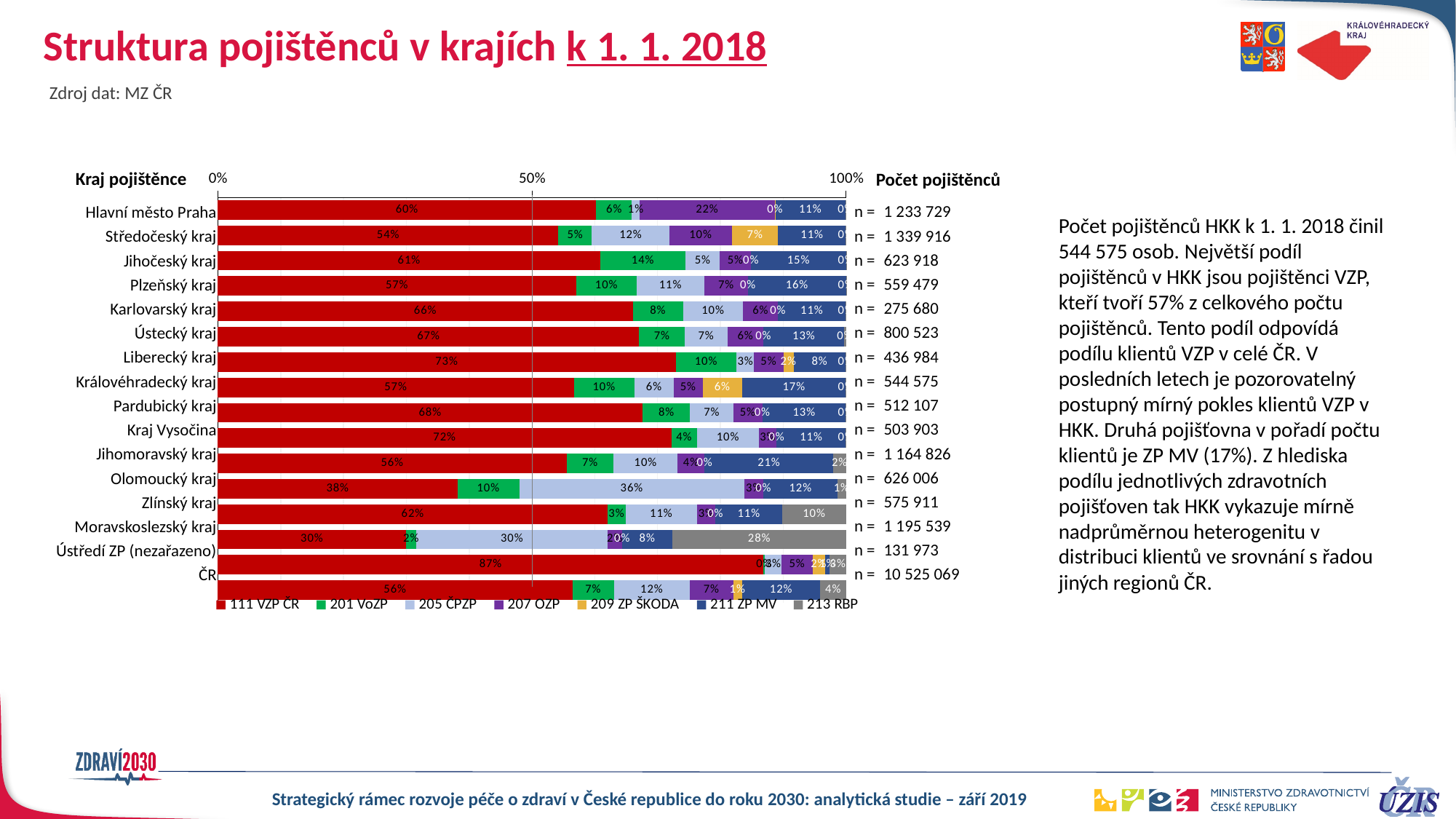
How many series does the chart legend list? 7 What is the share of 111 VZP ČR for Královéhradecký kraj? 57% What is the share of 211 ZP MV for Královéhradecký kraj? 17% How many rows (regions including ČR and Ústředí ZP) are plotted in the chart? 16 What is the difference between the 111 VZP ČR share of Liberecký kraj and that of Olomoucký kraj? 35 percentage points What is the share of 205 ČPZP for Olomoucký kraj? 36% Which row has the highest share of 111 VZP ČR? Ústředí ZP (nezařazeno) What is the share of 213 RBP for Moravskoslezský kraj? 28% What kind of chart is shown on the slide? stacked bar chart Which row has the lowest share of 111 VZP ČR? Moravskoslezský kraj What is the number of insured persons (n) shown for Královéhradecký kraj? 544 575 Which has a larger share of 111 VZP ČR, Liberecký kraj or Jihomoravský kraj? Liberecký kraj